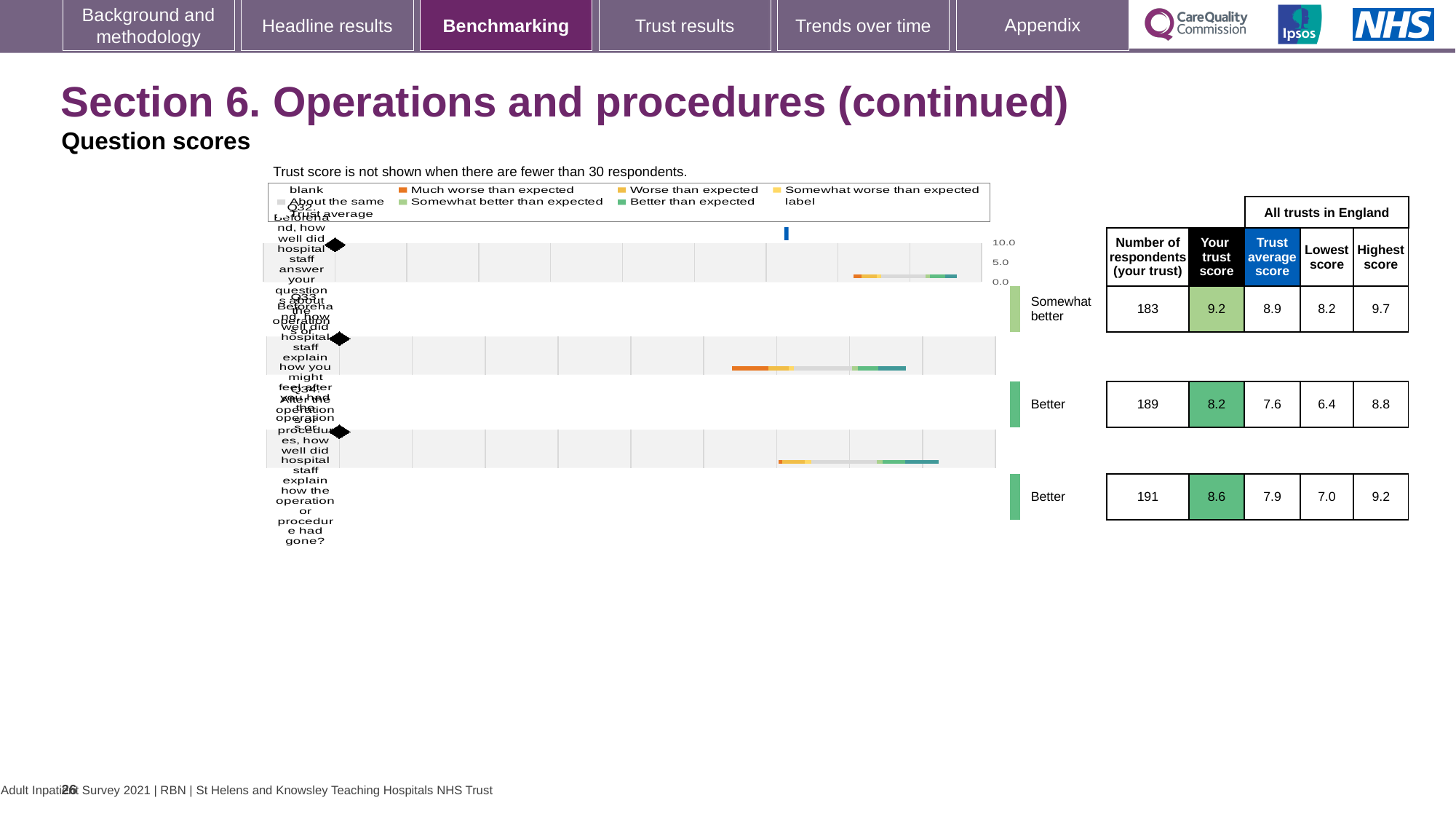
What kind of chart is used to show the question scores on this slide? bar chart Which question has the highest 'Your trust score'? Q32 Which is larger: the trust score for Q32 or the trust score for Q33? Q32 What is the difference between the highest score and the lowest score for Q32? 1.5 What is the trust average score for Q34? 7.9 How many questions (rows) are plotted in the chart? 3 Which question has the lowest 'Lowest score' value? Q33 What is the highest score across all trusts in England for Q33? 8.8 What benchmark category label is shown next to Q32? Somewhat better By how much does the trust score for Q34 exceed the trust average score for Q34? 0.7 How many respondents are shown for Q33? 189 What is the 'Your trust score' value for Q32? 9.2